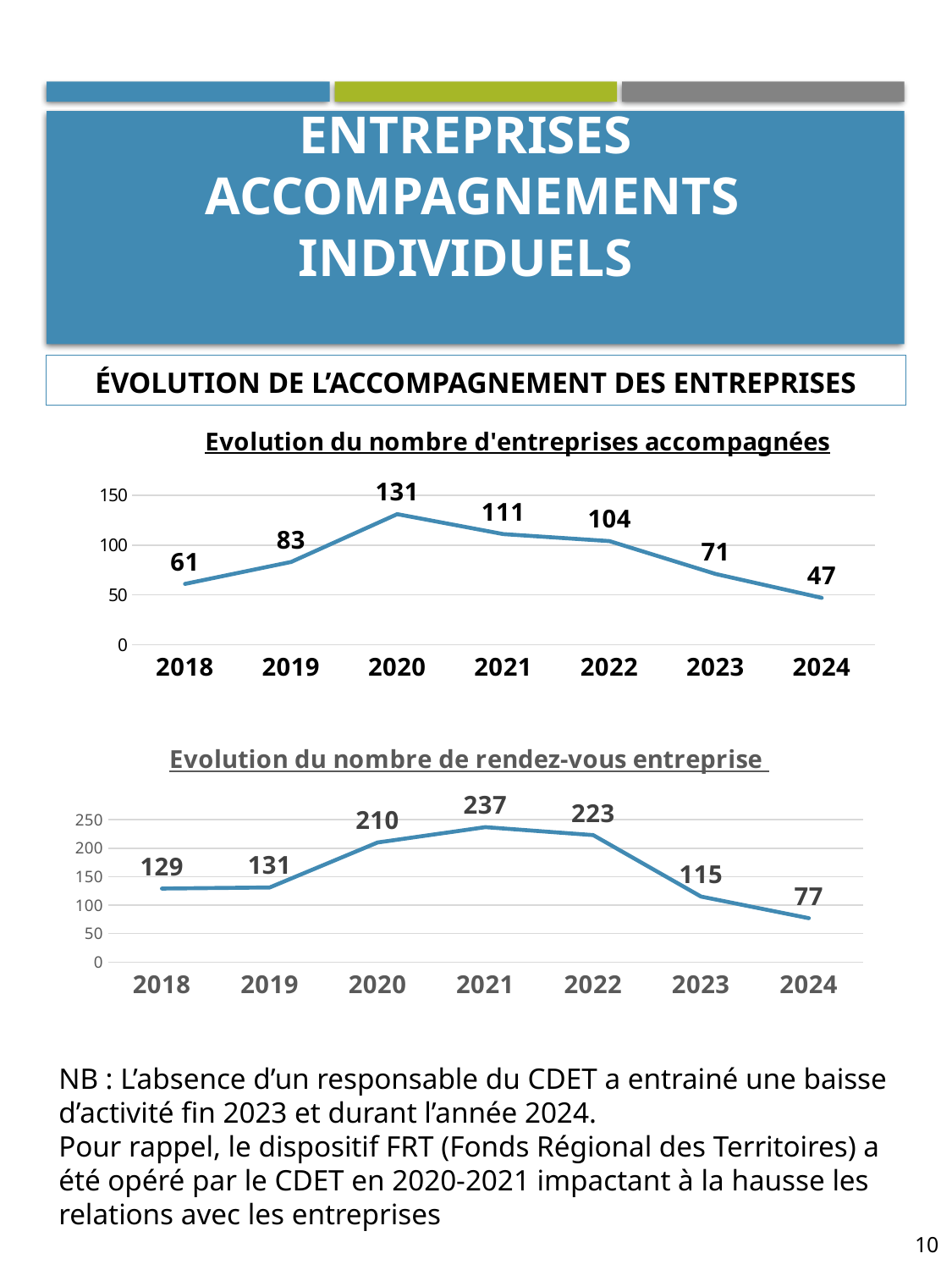
In the chart 'Evolution du nombre de rendez-vous entreprise', which year has the highest value? 2021 In the chart 'Evolution du nombre de rendez-vous entreprise', what is the difference between the values for 2022 and 2023? 108 In the chart 'Evolution du nombre de rendez-vous entreprise', is the value for 2024 greater or less than 100? less In the chart 'Evolution du nombre d'entreprises accompagnées', what is the difference between the values for 2020 and 2024? 84 In the chart 'Evolution du nombre d'entreprises accompagnées', what is the value for 2018? 61 In the chart 'Evolution du nombre d'entreprises accompagnées', do the values rise or fall from 2020 to 2024? fall What kind of chart is 'Evolution du nombre de rendez-vous entreprise'? line chart In the chart 'Evolution du nombre de rendez-vous entreprise', what is the value for 2021? 237 In the chart 'Evolution du nombre d'entreprises accompagnées', how many years are plotted? 7 In the chart 'Evolution du nombre de rendez-vous entreprise', which is larger, the value for 2018 or the value for 2019? 2019 In the chart 'Evolution du nombre d'entreprises accompagnées', which year has the lowest value? 2024 In the chart 'Evolution du nombre d'entreprises accompagnées', what is the value for 2020? 131